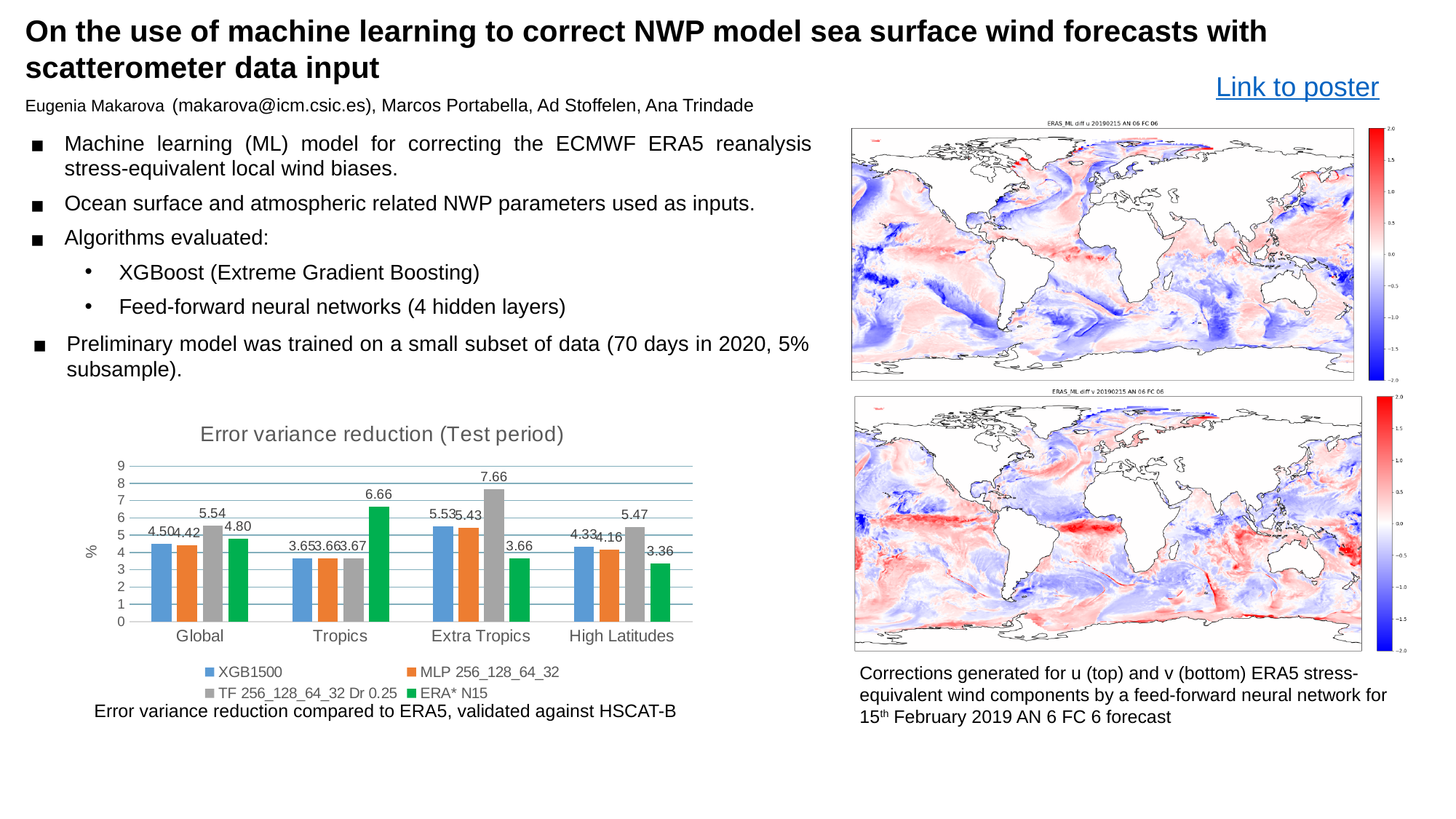
In the Error variance reduction (Test period) chart, what is the value for XGB1500 in the Global category? 4.50 In the Error variance reduction (Test period) chart, which category has the lowest value for ERA* N15? High Latitudes In the Error variance reduction (Test period) chart, which is larger in the Global category: XGB1500 or ERA* N15? ERA* N15 In the Error variance reduction (Test period) chart, which category has the highest value for TF 256_128_64_32 Dr 0.25? Extra Tropics In the Error variance reduction (Test period) chart, what is the value for TF 256_128_64_32 Dr 0.25 in the Extra Tropics category? 7.66 In the Error variance reduction (Test period) chart, what is the difference between the TF 256_128_64_32 Dr 0.25 value and the MLP 256_128_64_32 value in the Global category? 1.12 In the Error variance reduction (Test period) chart, what is the difference between the TF 256_128_64_32 Dr 0.25 value and the ERA* N15 value in the Extra Tropics category? 4.00 What is the y-axis label of the Error variance reduction (Test period) chart? % In the Error variance reduction (Test period) chart, what is the value for ERA* N15 in the Tropics category? 6.66 How many series does the legend of the Error variance reduction (Test period) chart list? 4 How many categories are shown on the x axis of the Error variance reduction (Test period) chart? 4 What kind of chart is the Error variance reduction (Test period) chart? Bar chart